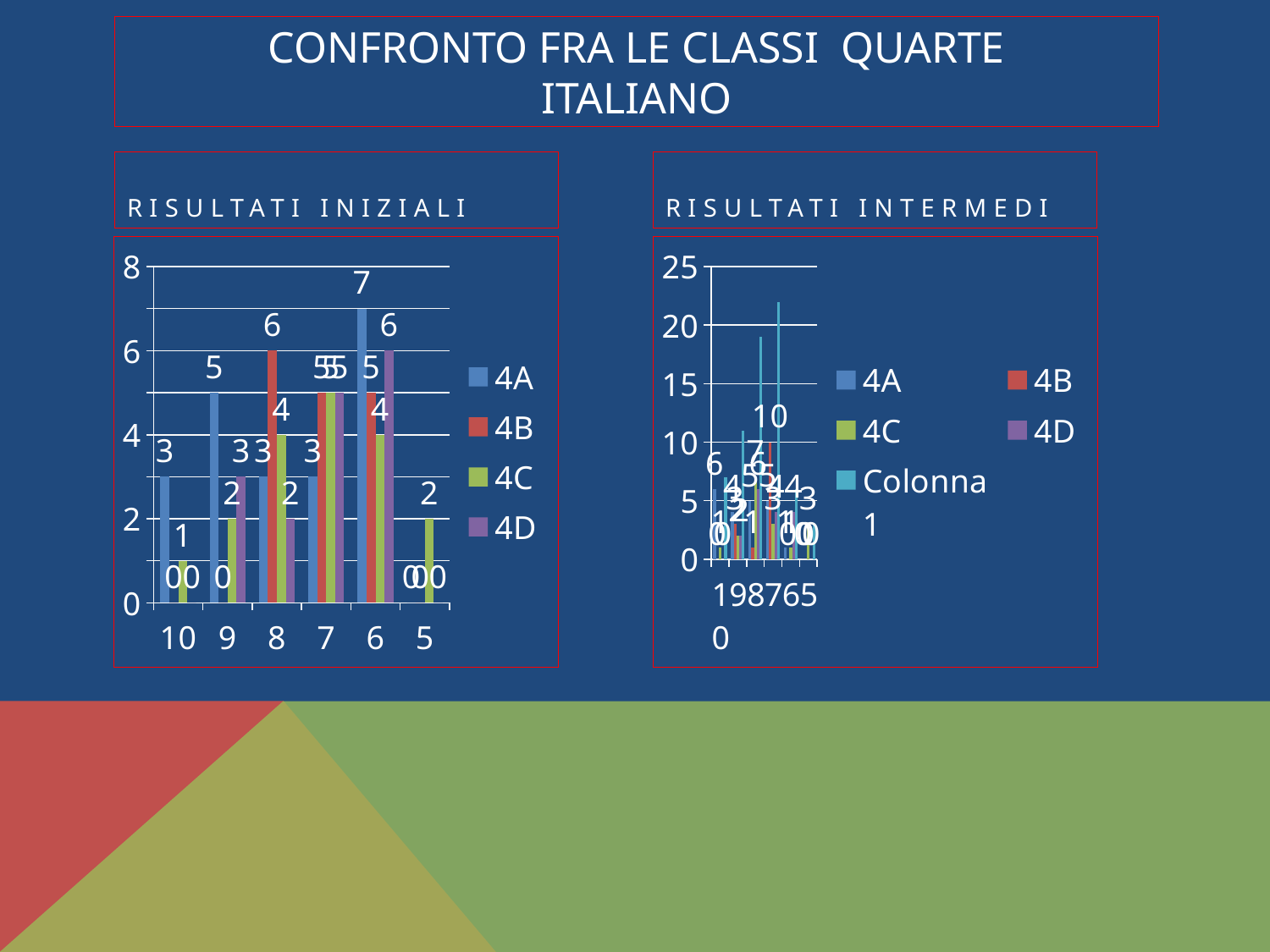
In the RISULTATI INIZIALI chart, at category 9, which is larger: 4A or 4C? 4A In the RISULTATI INIZIALI chart, what is the difference between 4A and 4D at category 6? 1 How many series does the legend of the RISULTATI INIZIALI chart list? 4 In the RISULTATI INIZIALI chart, what is the value for 4B at category 8? 6 In the RISULTATI INIZIALI chart, what is the value for 4C at category 5? 2 How many series does the legend of the RISULTATI INTERMEDI chart list? 5 What is the fifth legend entry in the RISULTATI INTERMEDI chart? Colonna 1 In the RISULTATI INIZIALI chart, what is the value for 4A at category 6? 7 In the RISULTATI INIZIALI chart, what is the value for 4C at category 10? 1 In the RISULTATI INIZIALI chart, at which category does 4A reach its highest value? 6 How many categories are shown on the x axis of the RISULTATI INIZIALI chart? 6 What kind of chart is the RISULTATI INTERMEDI chart? bar chart